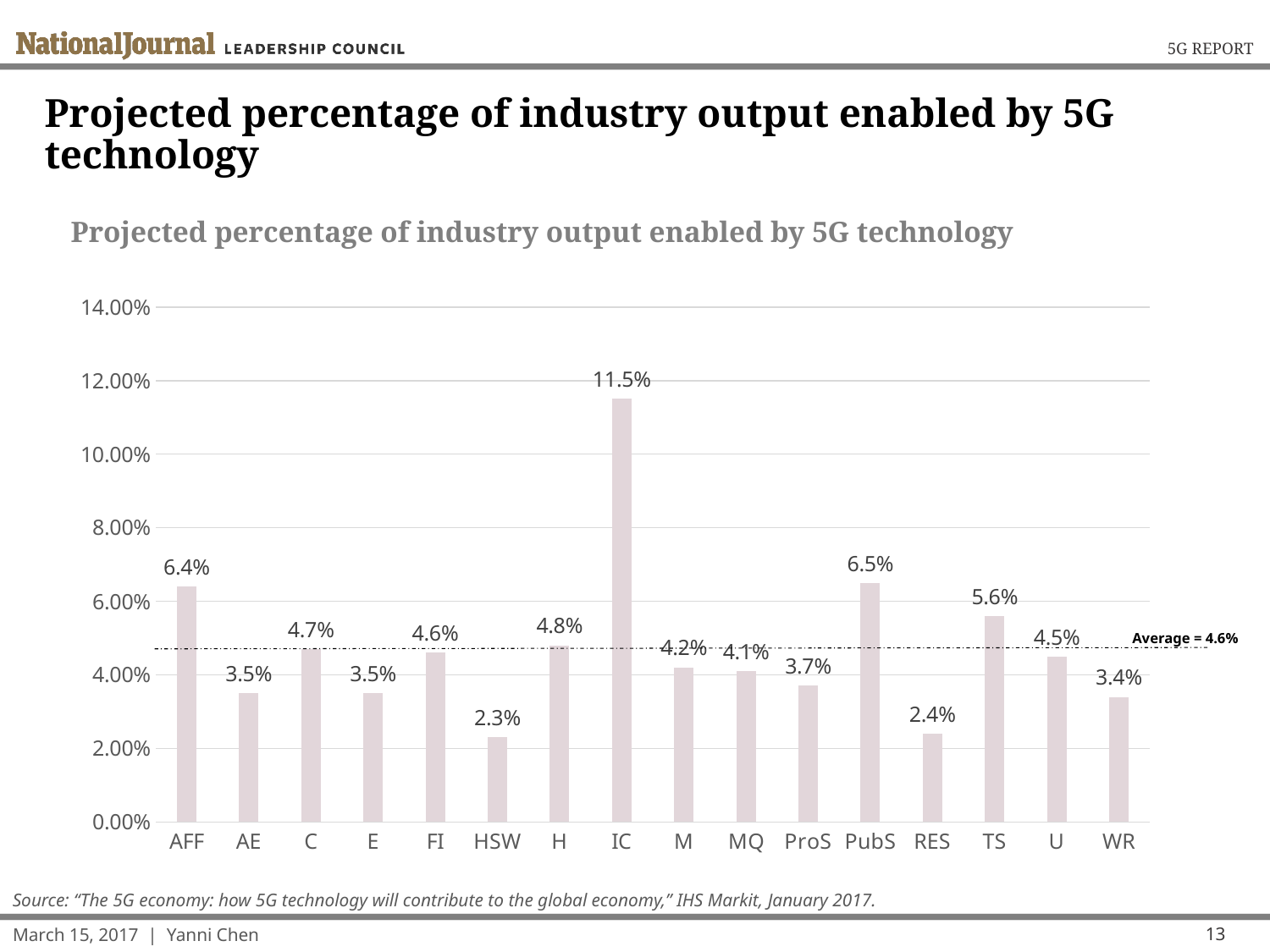
How many categories are shown on the x axis? 16 What is the value shown for PubS? 6.5% What is the difference between the values for AFF and WR? 3.0% What is the projected percentage of industry output enabled by 5G for IC? 11.5% What kind of chart is shown on the slide? Bar chart What is the difference between the values for IC and PubS? 5.0% Which category has the lowest projected percentage? HSW What is the value shown for HSW? 2.3% Which is larger, the value for RES or the value for ProS? ProS Which is larger, the value for TS or the value for U? TS What average value is marked by the dashed line on the chart? 4.6% Which category has the highest projected percentage? IC